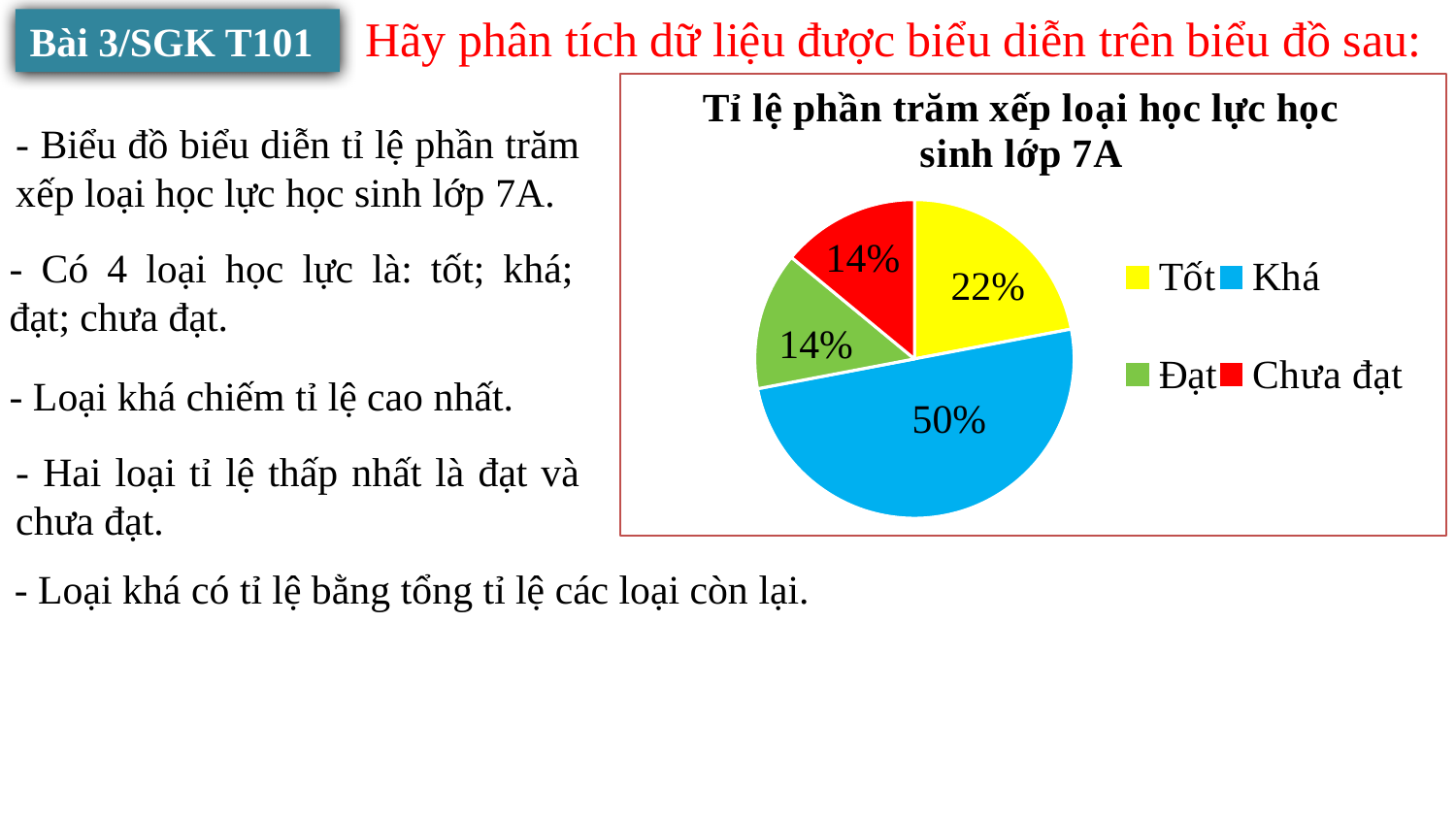
What percentage of the pie is the Khá slice? 50% What is the title of the chart? Tỉ lệ phần trăm xếp loại học lực học sinh lớp 7A Which category has the largest share of the pie? Khá What is the difference between the Khá share and the Tốt share? 28% How many categories does the legend list? 4 What colour is the Khá slice in the pie chart? blue What percentage of the pie is the Tốt slice? 22% What percentage of the pie is the Đạt slice? 14% What kind of chart is shown on the slide? pie chart Which is larger, the Tốt slice or the Đạt slice? Tốt What percentage of the pie is the Chưa đạt slice? 14% How many slices does the pie chart have? 4